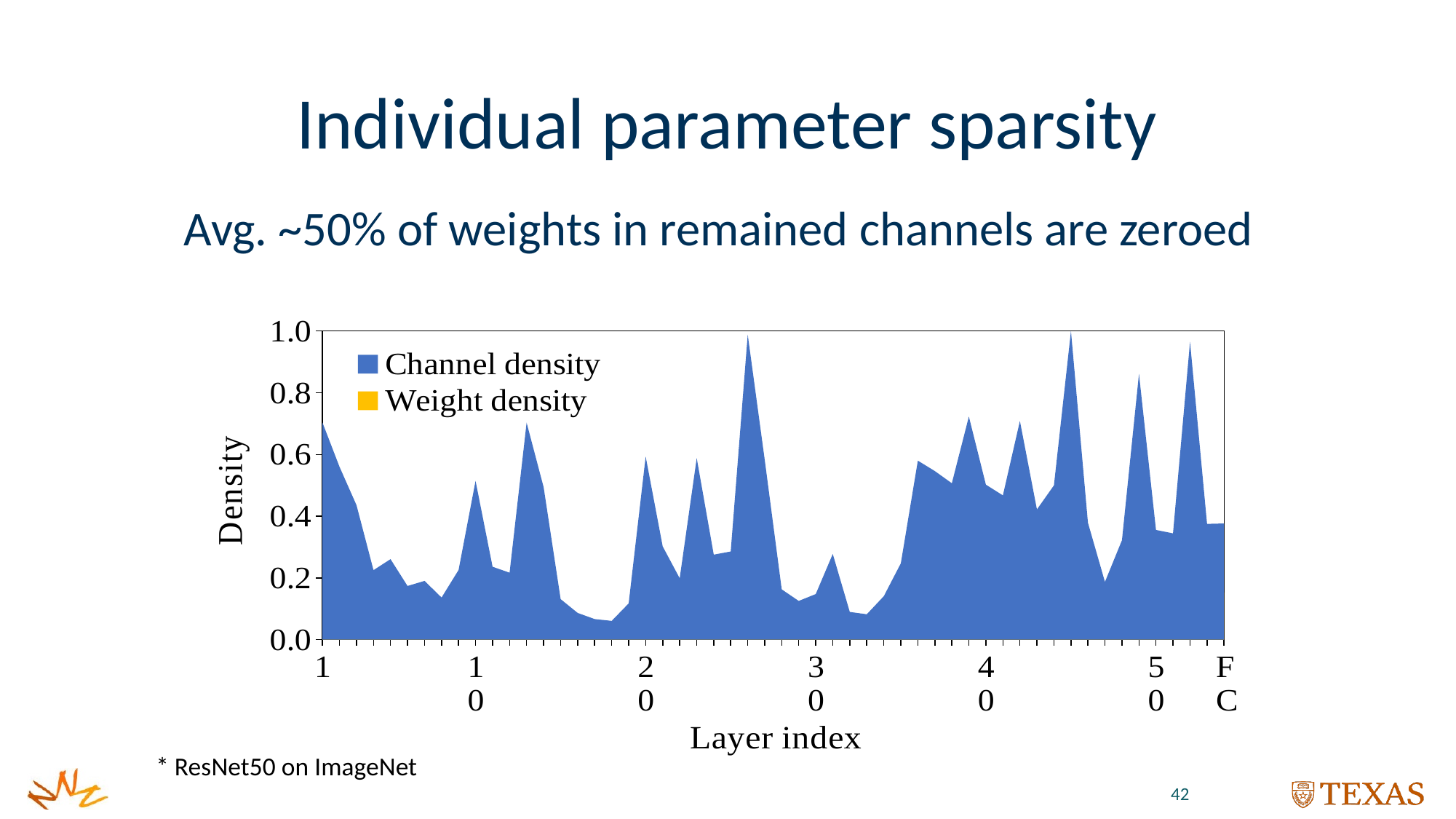
How many series does the chart legend list? 2 What kind of chart is shown on the slide? area chart Which has the larger Channel density: layer index 40 or layer index 50? layer index 40 Is the Channel density value at layer index 1 greater or less than 0.6? greater What is the title of the chart's y axis? Density Which has the larger Channel density: layer index 1 or layer index 30? layer index 1 Is the Channel density value at the FC layer greater or less than 0.6? less Is the Channel density value at layer index 40 greater or less than 0.6? less What is the highest value shown on the chart's y axis? 1.0 What are the two series named in the chart legend? Channel density and Weight density